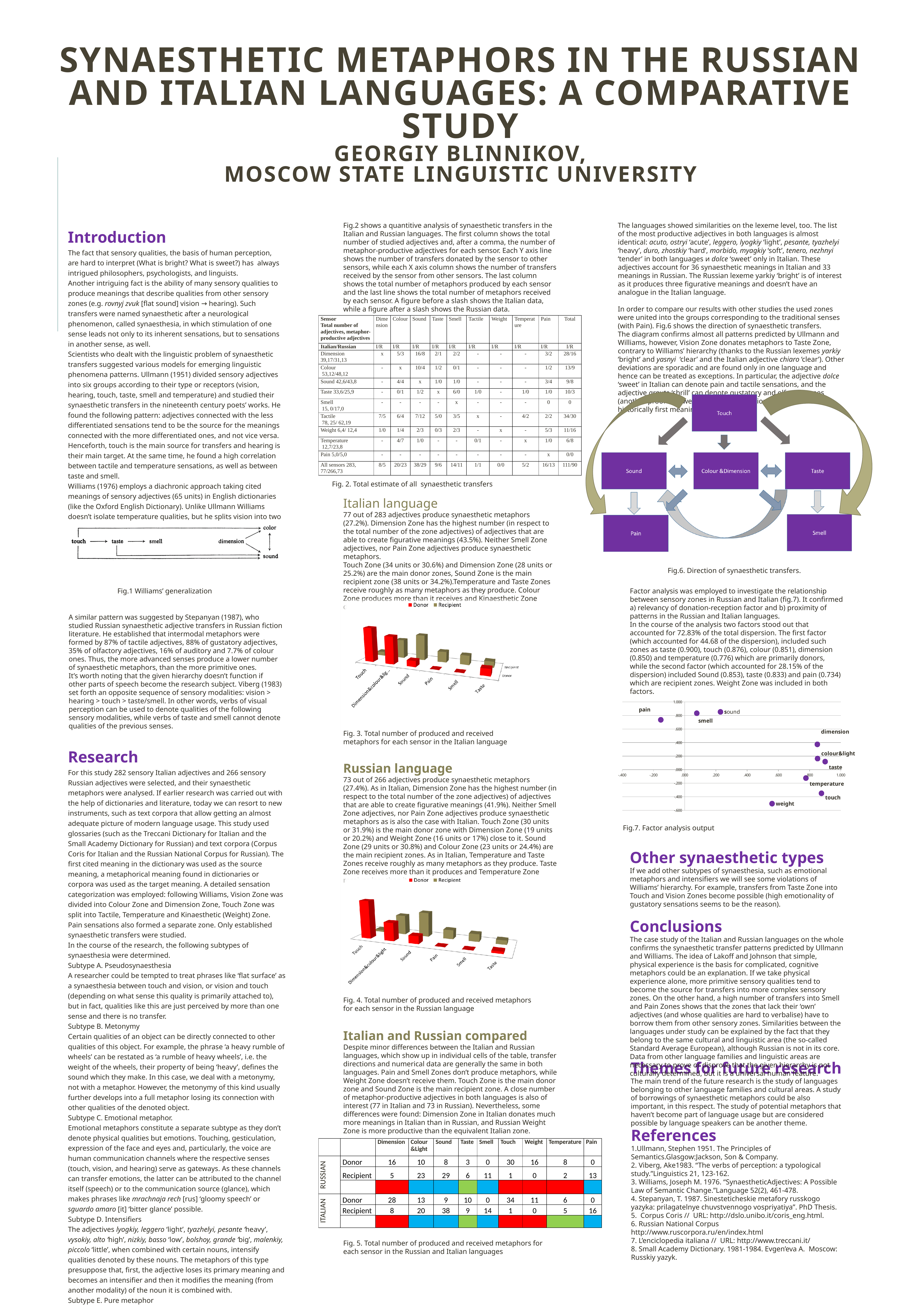
How many sensor categories are shown along the x axis of Fig. 3 (Italian language)? 6 What are the two legend entries in Fig. 3 (Italian language)? Donor and Recipient In Fig. 4 (Russian language), which colour represents the Donor series? red In Fig. 3 (Italian language), which sensor has the tallest Donor bar? Touch What kind of chart is Fig. 4 (Total number of produced and received metaphors for each sensor in the Russian language)? bar chart How many labelled points are plotted in Fig. 7 (Factor analysis output)? 9 In Fig. 7 (Factor analysis output), is the vertical-axis value for weight greater or less than -.400? less What kind of chart is Fig. 3 (Total number of produced and received metaphors for each sensor in the Italian language)? bar chart How many series does the legend of Fig. 3 (Italian language) list? 2 In Fig. 4 (Russian language), which sensor has the tallest Donor bar? Touch What kind of chart is Fig. 7 (Factor analysis output)? scatter chart In Fig. 3 (Italian language), which sensor has the tallest Recipient bar? Sound